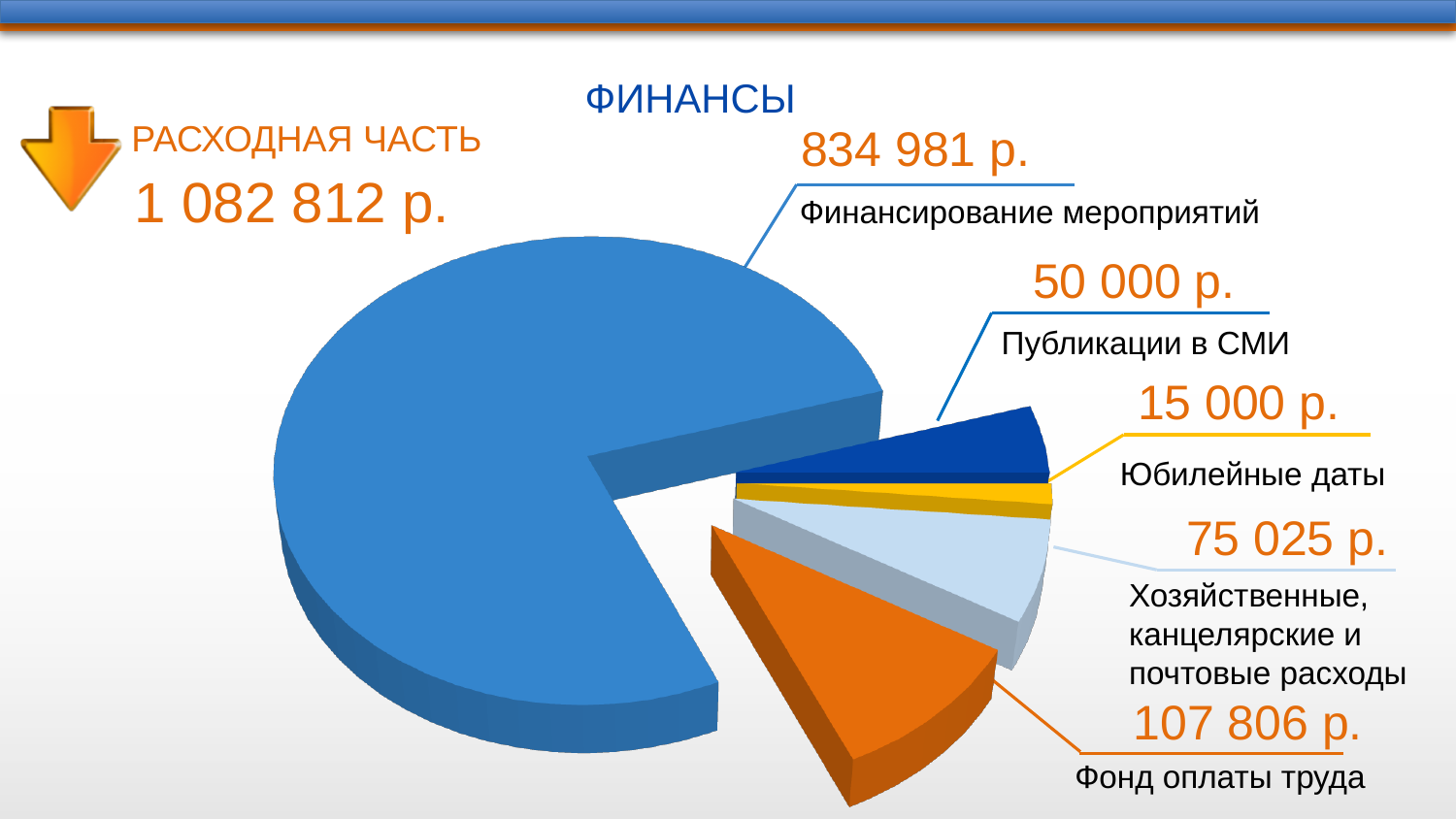
What type of chart is shown on the slide? Pie chart What is the value for Фонд оплаты труда? 107 806 р. What is the value for Публикации в СМИ? 50 000 р. What is the value for Финансирование мероприятий? 834 981 р. Which category has the largest slice of the pie? Финансирование мероприятий Which is larger: Публикации в СМИ or Фонд оплаты труда? Фонд оплаты труда What is the difference between Фонд оплаты труда and Хозяйственные, канцелярские и почтовые расходы? 32 781 р. What is the value for Юбилейные даты? 15 000 р. What colour is the slice for Фонд оплаты труда? Orange How many slices does the pie chart have? 5 What is the value for Хозяйственные, канцелярские и почтовые расходы? 75 025 р. Which category has the smallest slice of the pie? Юбилейные даты